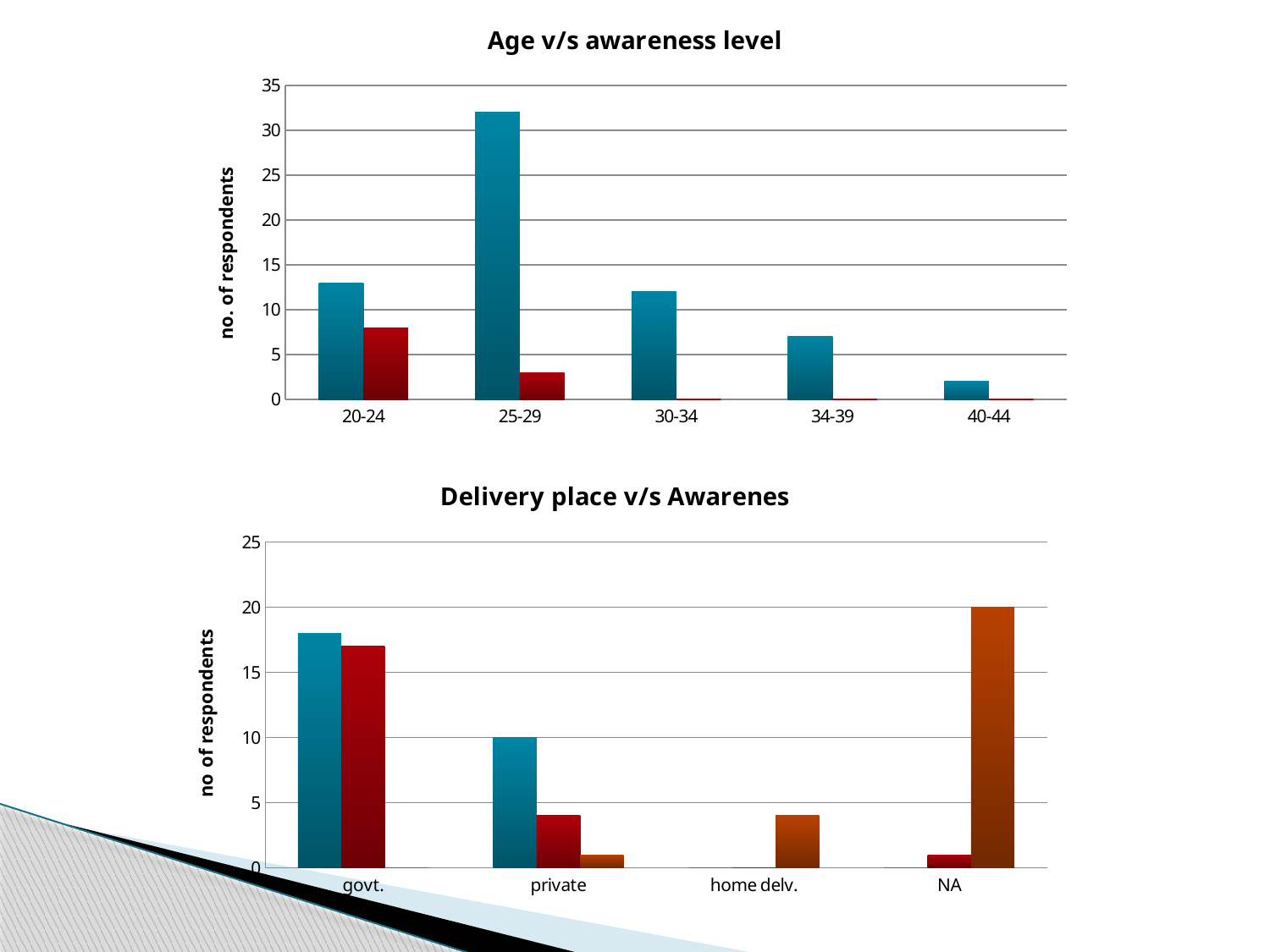
In the 'Delivery place v/s Awarenes' chart, which delivery place has the tallest orange bar? NA In the 'Age v/s awareness level' chart, is the blue bar for 20-24 greater or less than 10? greater In the 'Age v/s awareness level' chart, do the blue bars rise or fall from 25-29 to 40-44? fall In the 'Age v/s awareness level' chart, is the red bar for 25-29 greater or less than 5? less In the 'Delivery place v/s Awarenes' chart, how many delivery place categories are shown on the x axis? 4 What kind of chart is 'Delivery place v/s Awarenes'? bar chart In the 'Delivery place v/s Awarenes' chart, what is the value of the blue bar for private? 10 In the 'Delivery place v/s Awarenes' chart, what is the value of the orange bar for NA? 20 In the 'Age v/s awareness level' chart, which is larger for 20-24: the blue bar or the red bar? the blue bar In the 'Age v/s awareness level' chart, how many age groups are shown on the x axis? 5 In the 'Age v/s awareness level' chart, which age group has the tallest blue bar? 25-29 In the 'Age v/s awareness level' chart, is the blue bar for 25-29 greater or less than 30? greater